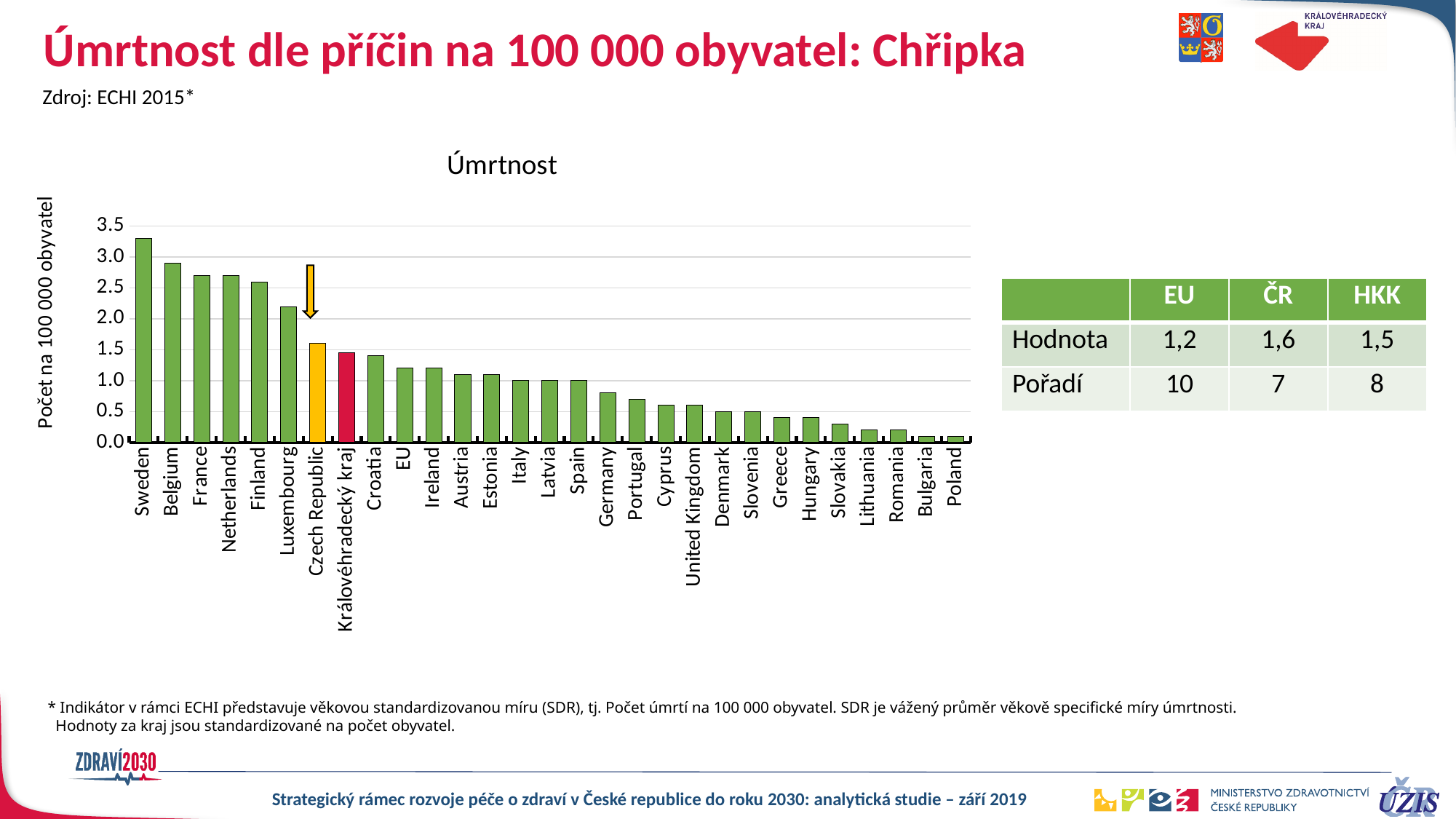
What is the difference between the values for Czech Republic and EU? 0,4 Which is larger, the value for Sweden or for Belgium? Sweden Is the value for Luxembourg greater or less than 2.0? greater Which is larger, the value for Czech Republic or for Královéhradecký kraj? Czech Republic Is the value for Germany greater or less than 0.5? greater Do the values rise or fall from left to right along the x axis? Fall Which country has the highest mortality value in the chart? Sweden What is the value for Czech Republic? 1,6 How many bars (categories) are shown in the chart? 29 What kind of chart is shown on the slide? Bar chart What is the value for Královéhradecký kraj? 1,5 What is the value for EU? 1,2